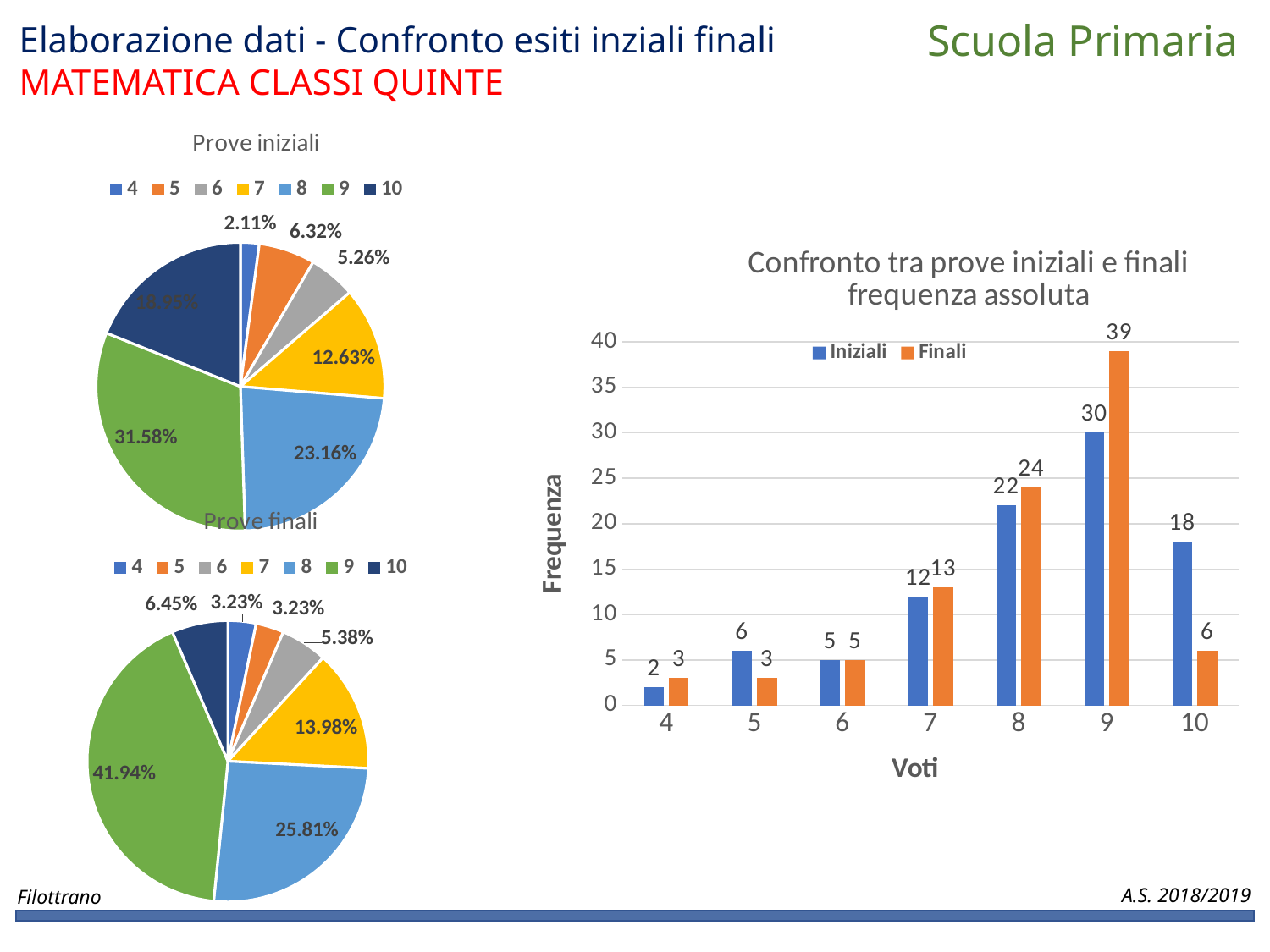
In the 'Confronto tra prove iniziali e finali frequenza assoluta' bar chart, what is the Finali value for voto 9? 39 How many series does the legend of the 'Confronto tra prove iniziali e finali frequenza assoluta' chart list? 2 What kind of chart is 'Confronto tra prove iniziali e finali frequenza assoluta'? bar chart In the 'Prove finali' pie chart, what share does voto 9 have? 41.94% In the 'Prove finali' pie chart, which voto has the largest slice? 9 In the 'Prove iniziali' pie chart, what share does voto 8 have? 23.16% In the 'Confronto tra prove iniziali e finali frequenza assoluta' bar chart, which voto has the lowest Iniziali value? 4 In the 'Confronto tra prove iniziali e finali frequenza assoluta' bar chart, what is the Iniziali value for voto 10? 18 In the 'Confronto tra prove iniziali e finali frequenza assoluta' bar chart, what is the difference between the Iniziali and Finali values for voto 10? 12 In the 'Confronto tra prove iniziali e finali frequenza assoluta' bar chart, for voto 5, which series has the larger value, Iniziali or Finali? Iniziali In the 'Confronto tra prove iniziali e finali frequenza assoluta' bar chart, which voto has the highest Finali value? 9 How many voti categories are shown on the x axis of the 'Confronto tra prove iniziali e finali frequenza assoluta' chart? 7